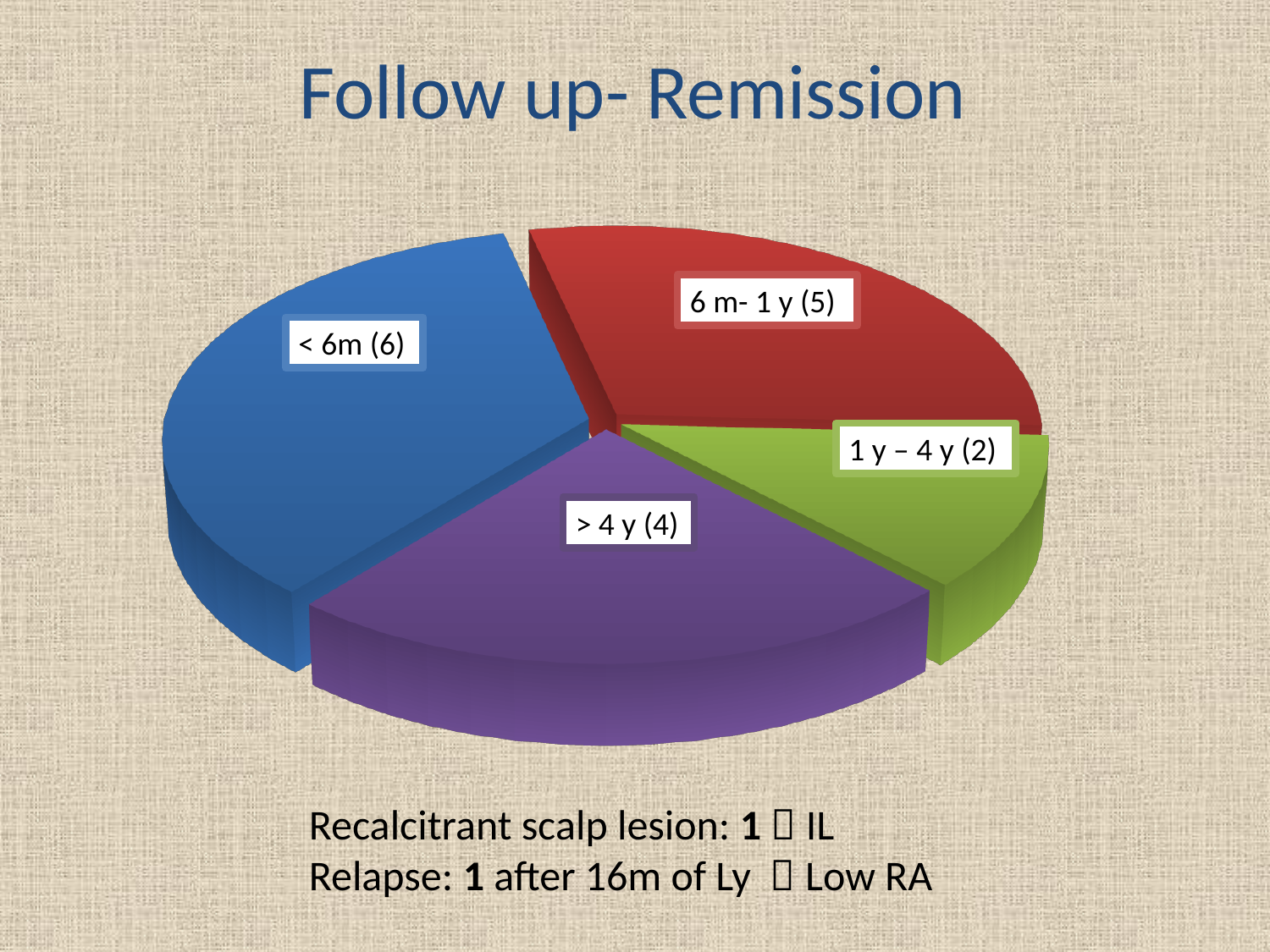
What is the title of the chart? Follow up- Remission What is the value shown for the "1 y – 4 y" slice? 2 Which is larger, the value for "6 m- 1 y" or the value for "> 4 y"? 6 m- 1 y What is the difference between the values for "< 6m" and "1 y – 4 y"? 4 What colour is the "> 4 y" slice? purple How many slices does the pie chart have? 4 Which slice has the largest value? < 6m What is the value shown for the "< 6m" slice? 6 What is the value shown for the "6 m- 1 y" slice? 5 What kind of chart is shown on the slide? pie chart What is the value shown for the "> 4 y" slice? 4 Which slice has the smallest value? 1 y – 4 y